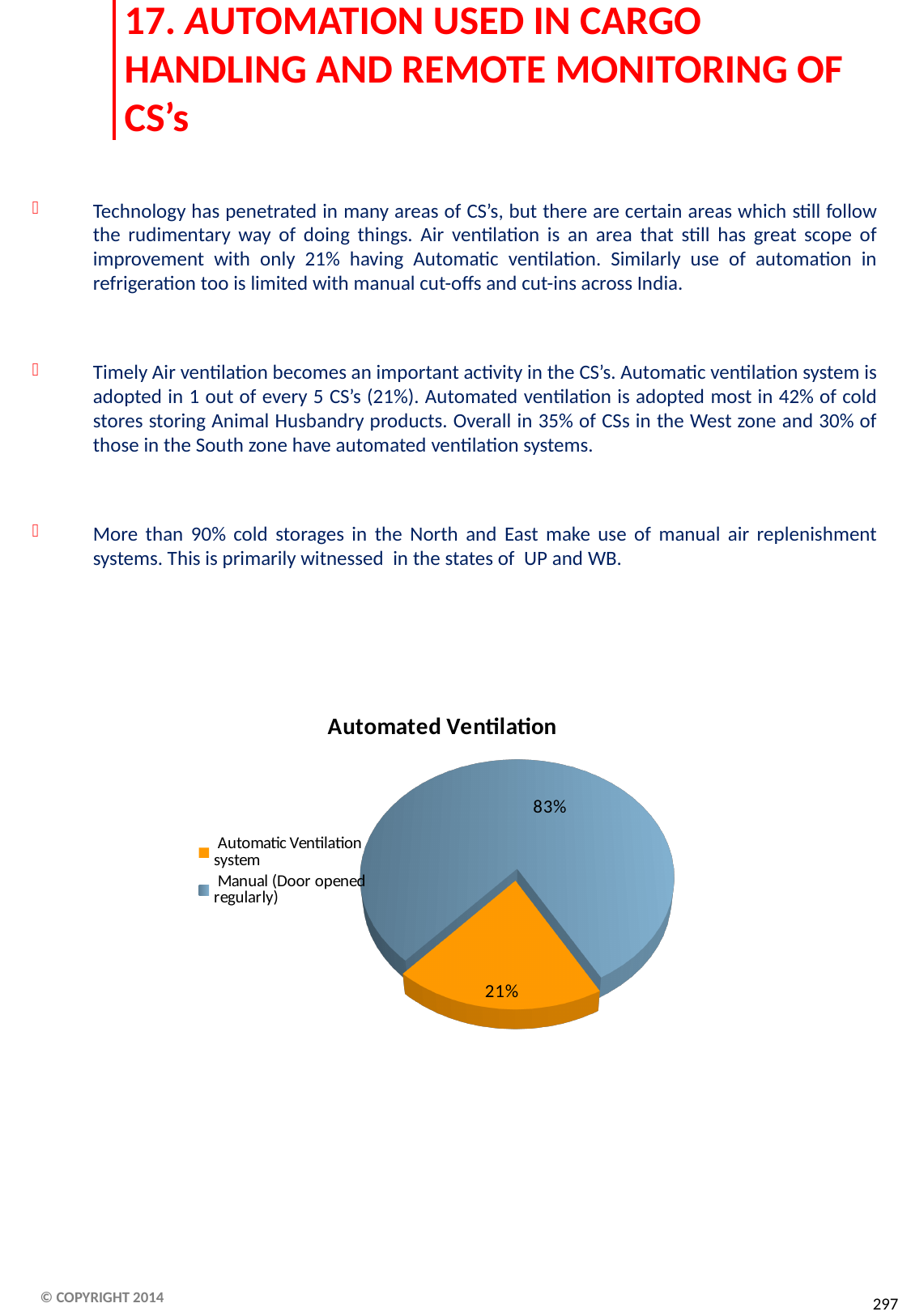
What type of chart is shown on the slide? Pie chart What is the title of the chart? Automated Ventilation What colour is the slice for Automatic Ventilation system? Orange Which category has the largest share of the pie? Manual (Door opened regularly) How many entries does the legend list? 2 What percentage of the pie is labelled for Manual (Door opened regularly)? 83% What is the difference in percentage points between the Manual (Door opened regularly) label and the Automatic Ventilation system label? 62 What percentage of the pie is labelled for Automatic Ventilation system? 21% How many slices does the pie chart have? 2 Which is larger: the share for Automatic Ventilation system or the share for Manual (Door opened regularly)? Manual (Door opened regularly) Which category has the smallest share of the pie? Automatic Ventilation system